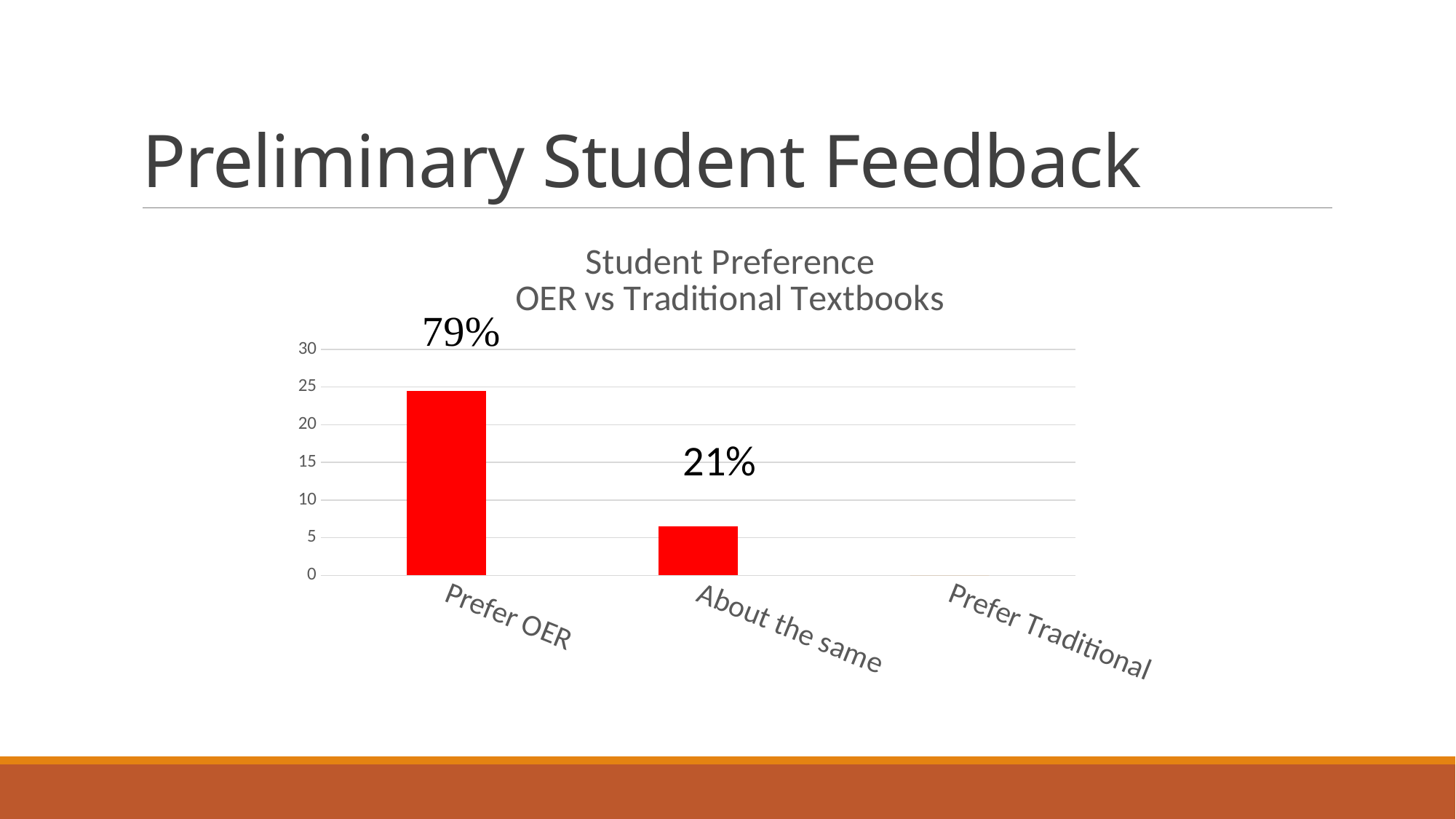
Which category has the highest bar in the chart? Prefer OER What percentage label is shown above the About the same bar? 21% Which is larger, the bar for Prefer OER or the bar for About the same? Prefer OER What kind of chart is shown on the slide? bar chart What is the difference between the percentage labels for Prefer OER and About the same? 58% Is the value for About the same greater or less than 10? less What is the title of the chart? Student Preference OER vs Traditional Textbooks How many categories are shown on the x axis of the chart? 3 What percentage label is shown above the Prefer OER bar? 79% What colour are the bars in the chart? red Which category has the lowest bar in the chart? Prefer Traditional Is the value for Prefer OER greater or less than 20? greater